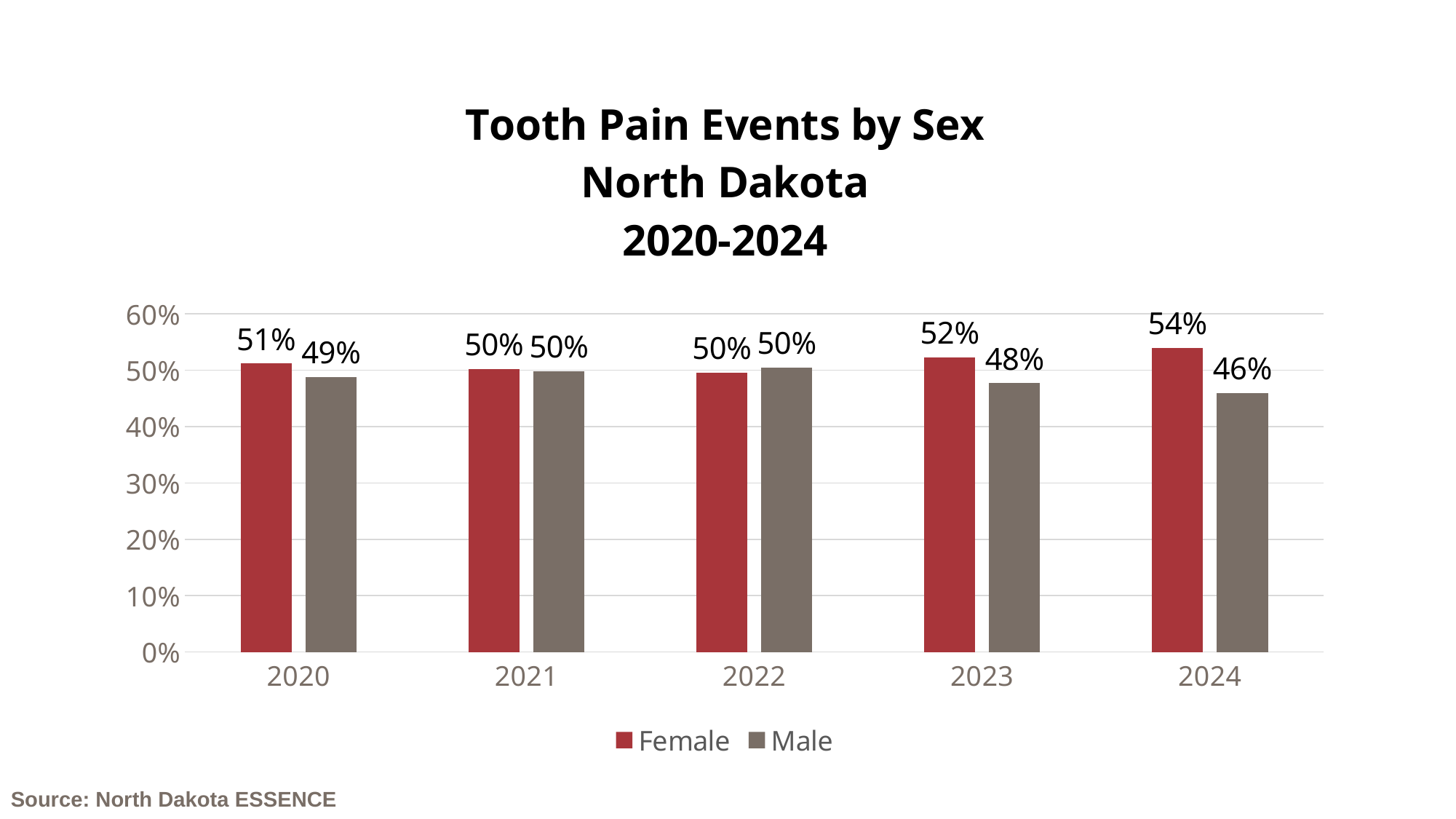
What is the Female value for 2024? 54% Is the Male value for 2024 greater or less than 50%? less In which year is the Female value highest? 2024 Does the Male value rise or fall from 2022 to 2024? fall What is the difference between the Female and Male values in 2024? 8% What is the Male value for 2023? 48% In which year is the Male value lowest? 2024 How many series does the legend list? 2 Which is larger in 2023, the Female value or the Male value? Female How many years are shown on the x axis? 5 What kind of chart is shown on the slide? bar chart What is the Male value for 2020? 49%